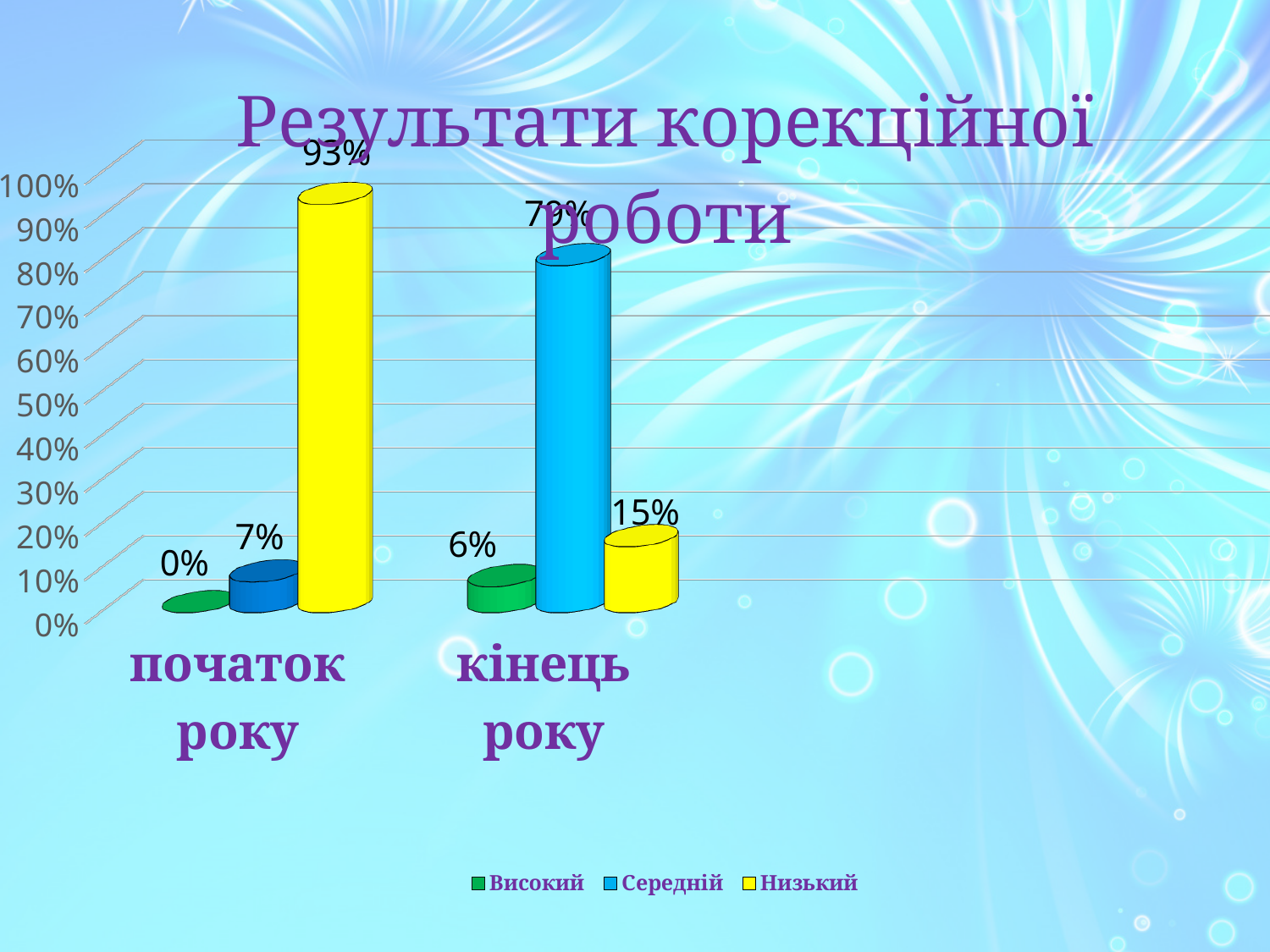
What is the value for Середній at початок року? 7% What is the value for Високий at кінець року? 6% Is the value for Середній at кінець року greater or less than 60%? greater Which series has the highest value at початок року? Низький What is the value for Низький at кінець року? 15% Which is larger: Високий at кінець року or Низький at кінець року? Низький at кінець року What is the difference between the Низький values at початок року and кінець року? 78% What is the value for Високий at початок року? 0% What is the value for Низький at початок року? 93% How many series does the legend list? 3 What kind of chart is shown on the slide? bar chart Which series has the lowest value at кінець року? Високий